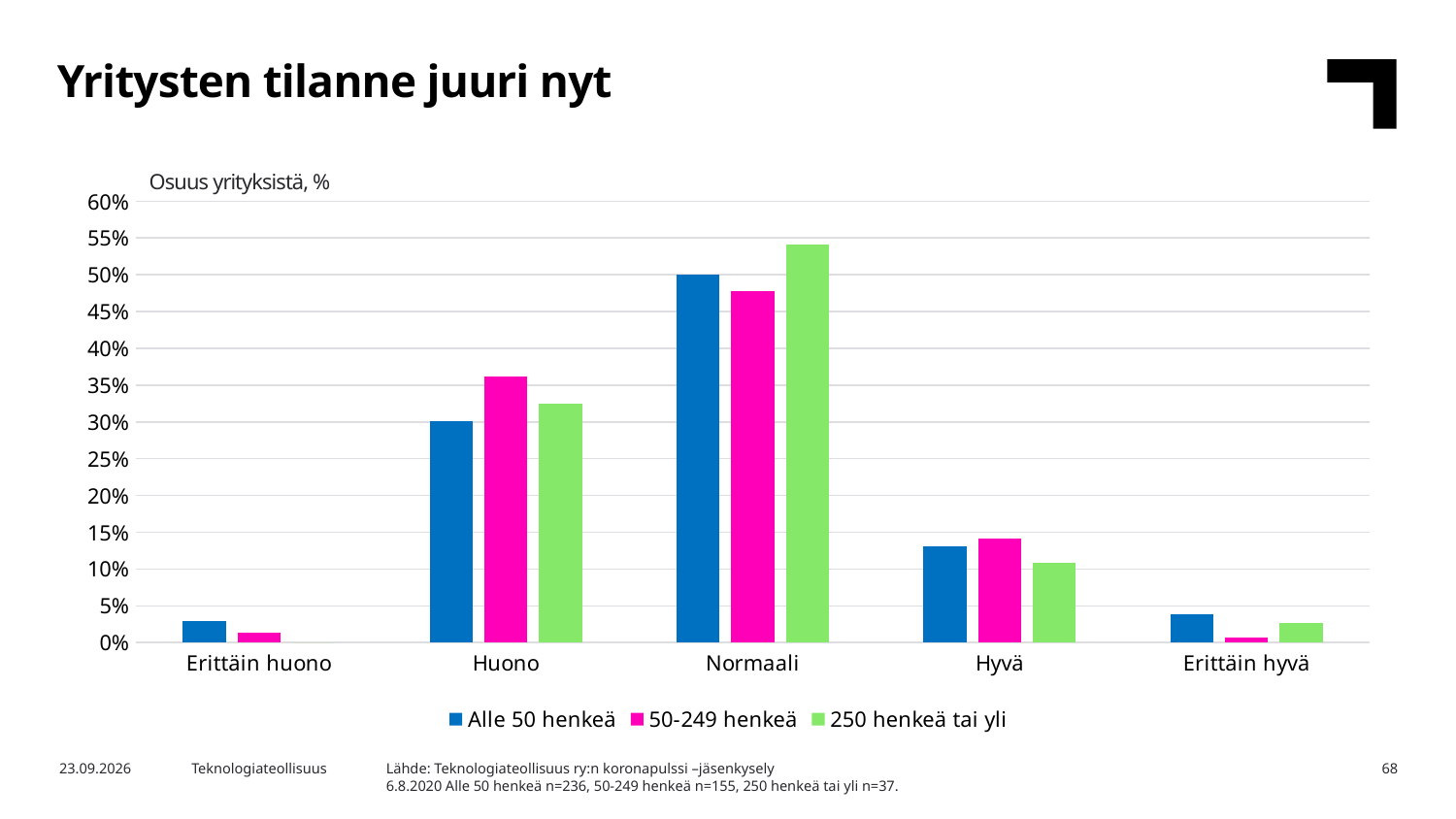
Is the value for '50-249 henkeä' in the 'Huono' category greater or less than 30%? greater In the 'Normaali' category, which series has the highest value? 250 henkeä tai yli What kind of chart is shown on the slide? bar chart Is the value for 'Alle 50 henkeä' in the 'Hyvä' category greater or less than 15%? less What is the title of the chart on the slide? Yritysten tilanne juuri nyt Is the value for '250 henkeä tai yli' in the 'Normaali' category greater or less than 50%? greater Which category has the highest value for the series '250 henkeä tai yli'? Normaali How many categories are shown on the x axis? 5 In the 'Huono' category, which series has the highest value? 50-249 henkeä For the series 'Alle 50 henkeä', which is larger: the value for 'Huono' or the value for 'Normaali'? Normaali In the 'Hyvä' category, which series has the lowest value? 250 henkeä tai yli How many series does the legend list? 3